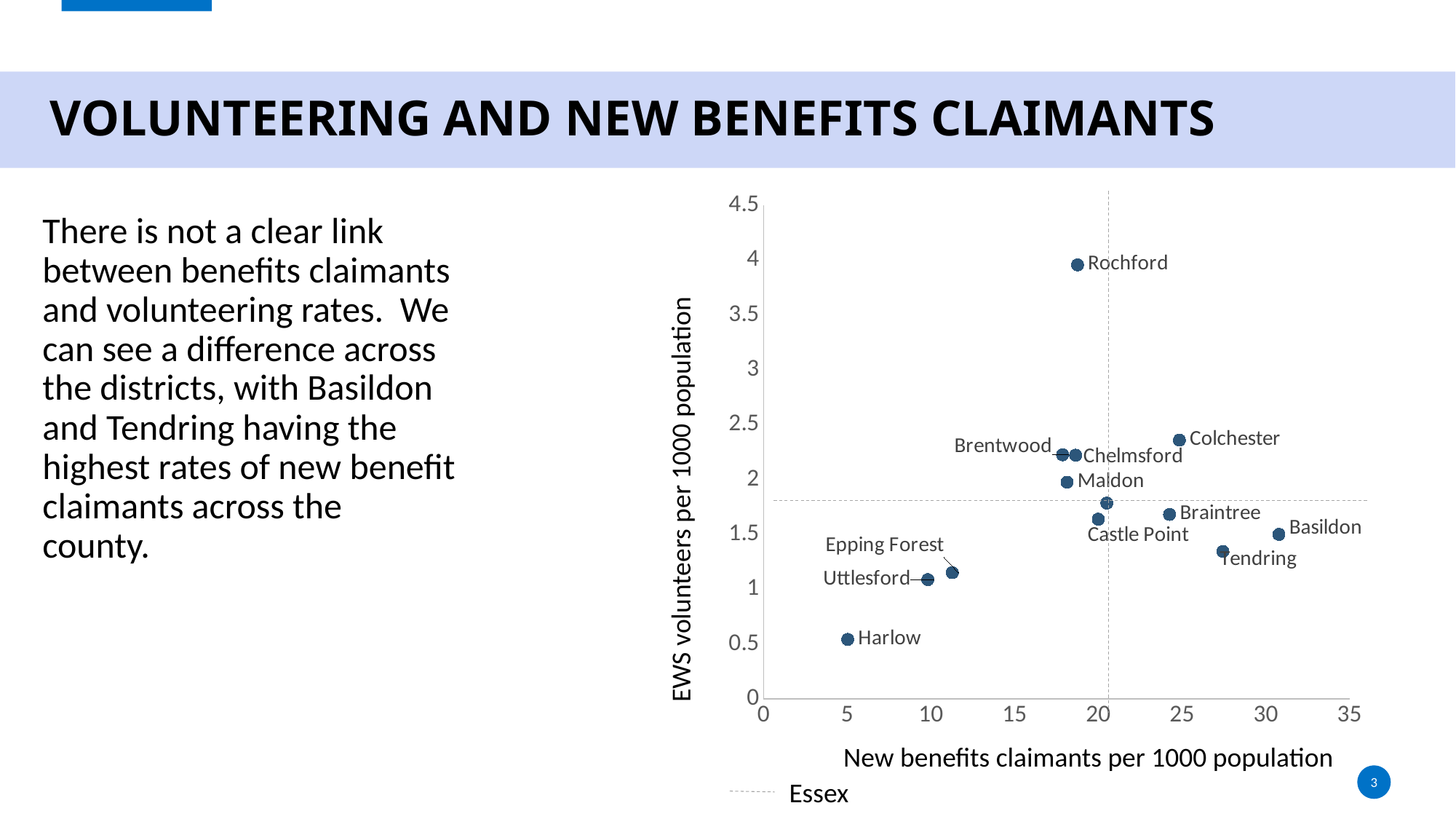
Is the EWS volunteers per 1000 population value for Harlow greater or less than 1? less Which has more EWS volunteers per 1000 population, Colchester or Tendring? Colchester What is the title of the horizontal axis of the chart? New benefits claimants per 1000 population Which district has the highest number of EWS volunteers per 1000 population? Rochford Which has more new benefits claimants per 1000 population, Tendring or Uttlesford? Tendring Is the new benefits claimants per 1000 population value for Basildon greater or less than 25? greater Is the EWS volunteers per 1000 population value for Rochford greater or less than 3.5? greater What entry does the chart legend list for the dashed reference lines? Essex Which district has the highest number of new benefits claimants per 1000 population? Basildon Which district has the lowest number of EWS volunteers per 1000 population? Harlow What kind of chart is shown on the slide? Scatter chart Which district has the lowest number of new benefits claimants per 1000 population? Harlow